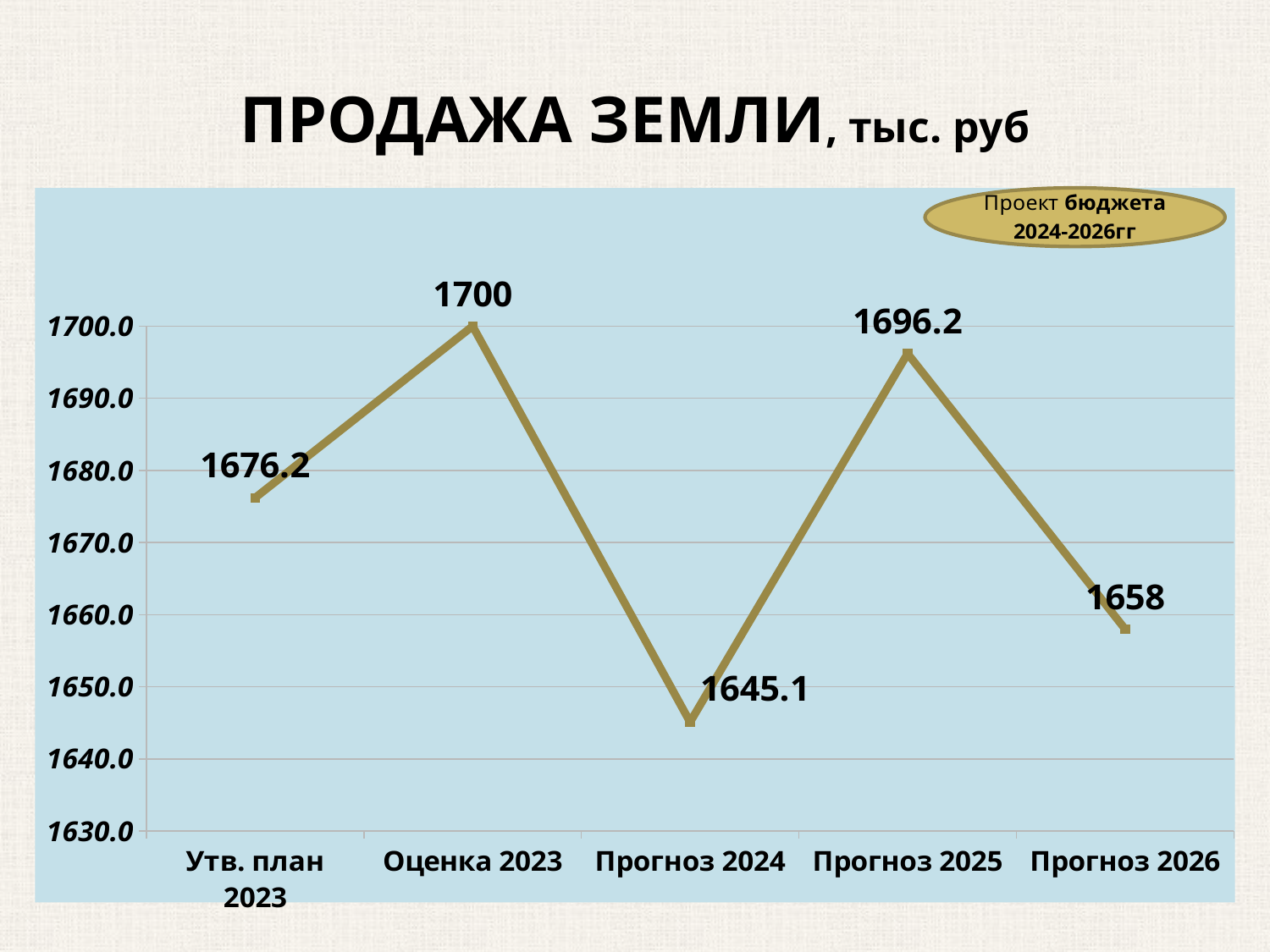
What is the title of the chart? ПРОДАЖА ЗЕМЛИ, тыс. руб Which category has the highest value? Оценка 2023 What is the difference between the values for Прогноз 2025 and Прогноз 2026? 38.2 What kind of chart is shown on the slide? line chart What is the value for Прогноз 2026? 1658 How many categories are shown on the x axis? 5 What is the difference between the values for Оценка 2023 and Прогноз 2024? 54.9 Which is larger, the value for Утв. план 2023 or the value for Прогноз 2026? Утв. план 2023 What is the value for Прогноз 2024? 1645.1 Which category has the lowest value? Прогноз 2024 What is the value for Утв. план 2023? 1676.2 What is the value for Оценка 2023? 1700